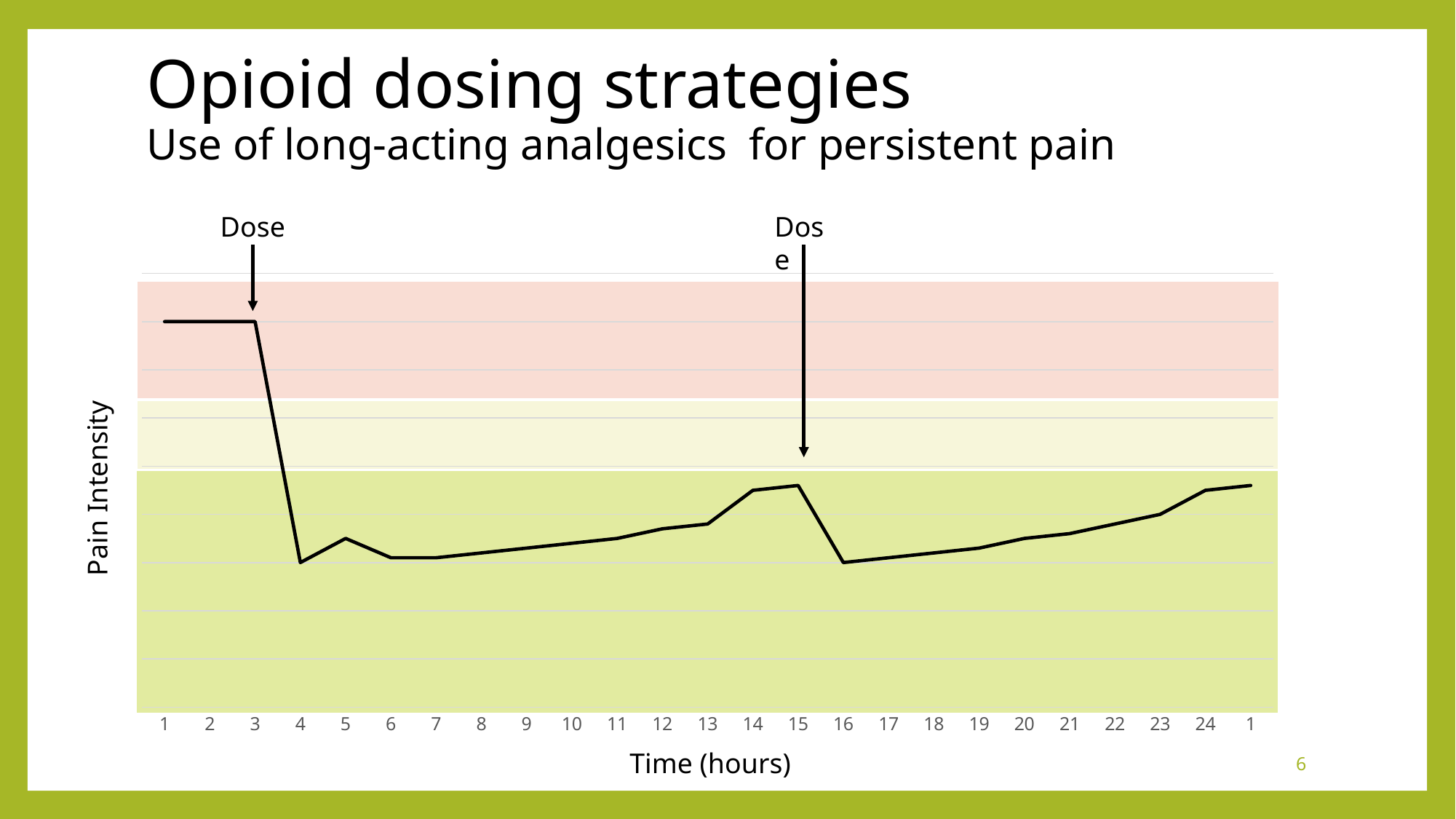
How many 'Dose' arrows are marked on the chart? 2 Does pain intensity rise or fall between hour 3 and hour 4? fall What is the label of the x axis of the chart? Time (hours) Which has the higher pain intensity, hour 15 or hour 16? hour 15 How many time points are labelled along the x axis of the chart? 25 What kind of chart is shown on the slide? line chart Which has the higher pain intensity, hour 1 or hour 4? hour 1 Which has the higher pain intensity, hour 2 or hour 24? hour 2 Does pain intensity rise or fall overall between hour 4 and hour 14? rise Does pain intensity rise or fall between hour 16 and hour 24? rise